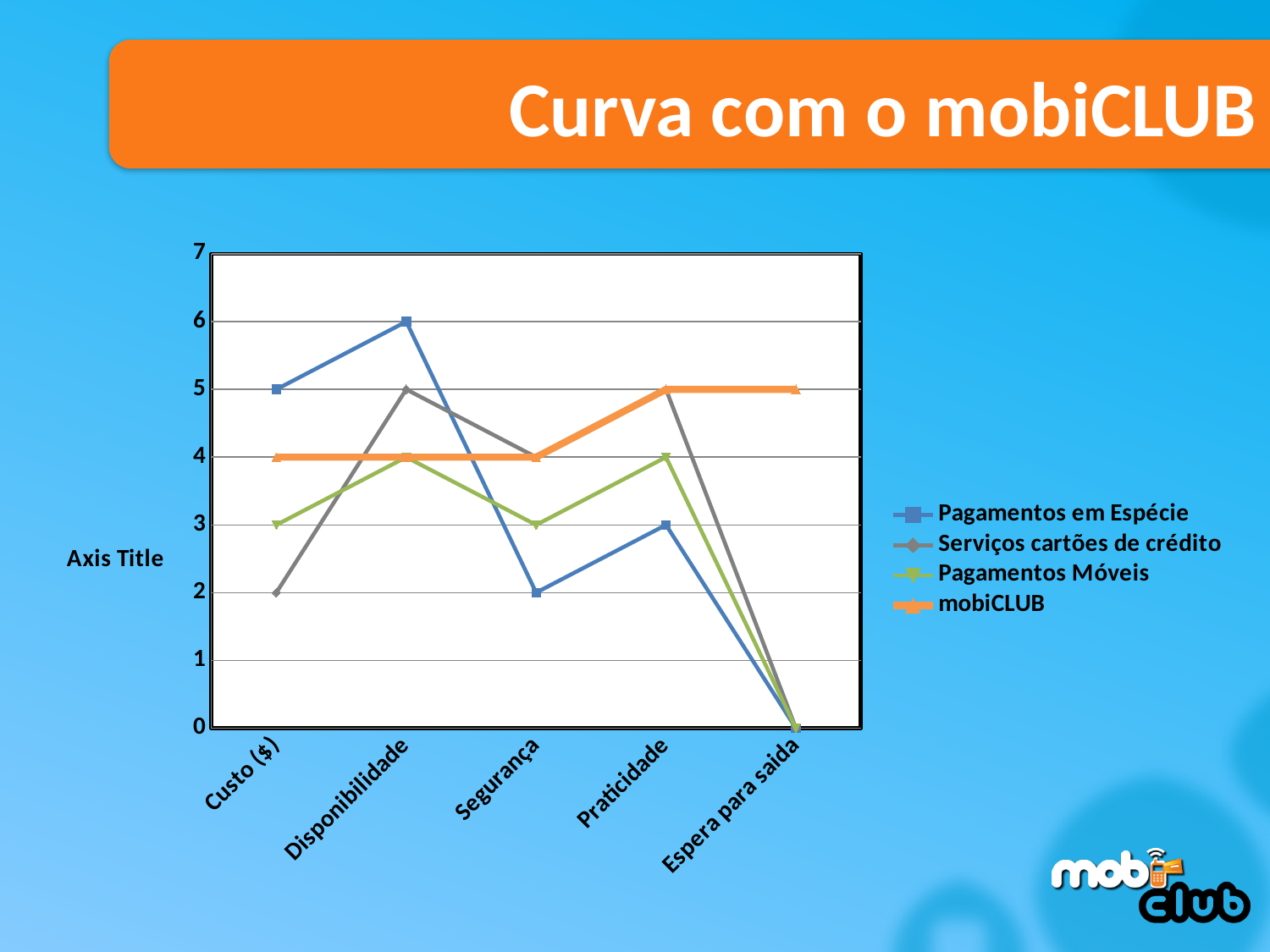
What is the difference between Pagamentos em Espécie and mobiCLUB for Segurança? 2 Which series is drawn with the thick orange line? mobiCLUB What kind of chart is shown on the slide? line chart For which category does Pagamentos em Espécie reach its highest value? Disponibilidade How many categories are shown on the x axis? 5 How many series does the legend list? 4 What is the value of Pagamentos em Espécie for Disponibilidade? 6 Which is larger for Praticidade: Pagamentos em Espécie or mobiCLUB? mobiCLUB What is the value of Serviços cartões de crédito for Custo ($)? 2 What is the value of Pagamentos Móveis for Praticidade? 4 Which series has the lowest value for Custo ($)? Serviços cartões de crédito What is the value of mobiCLUB for Espera para saida? 5